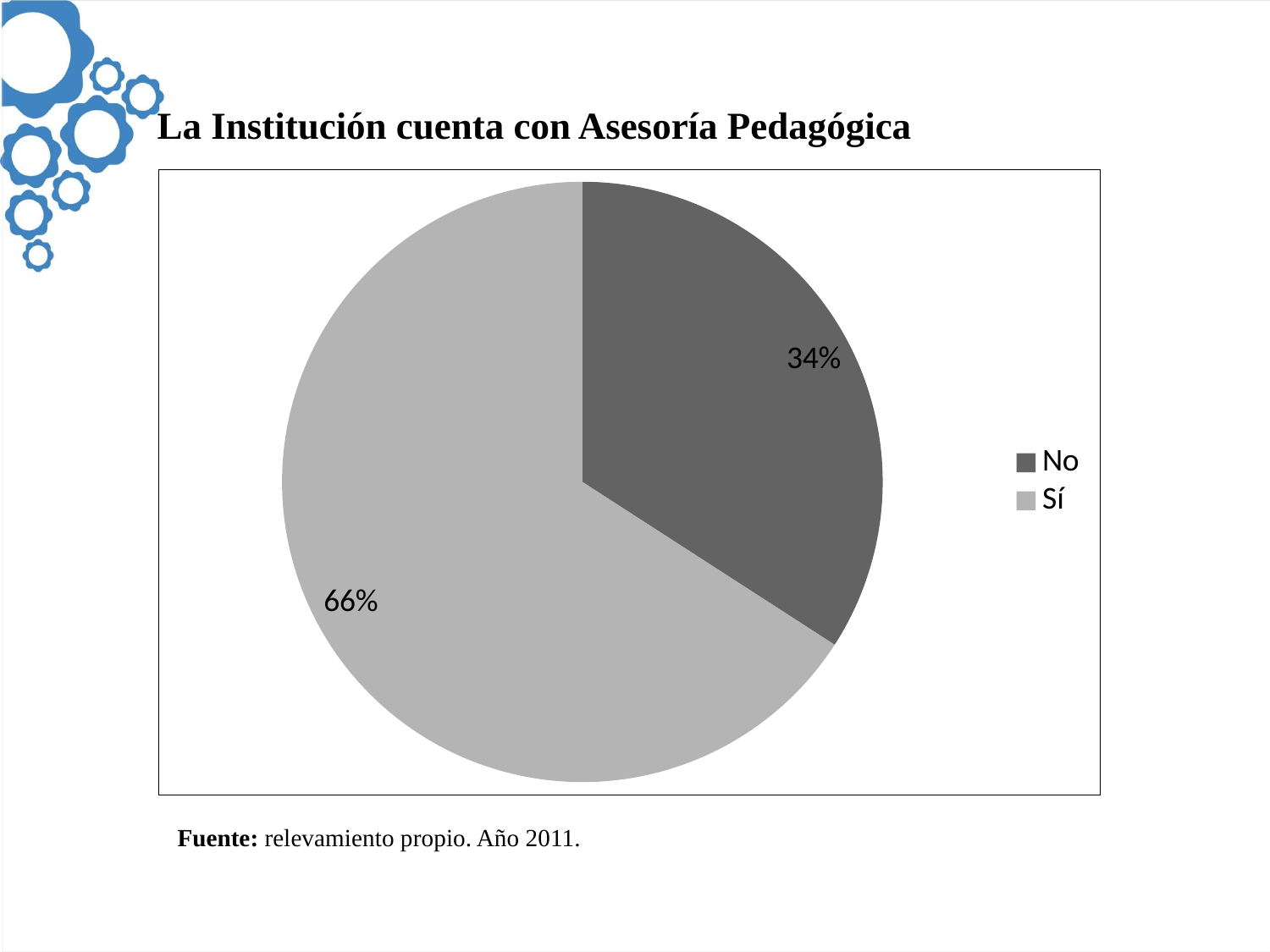
How many slices does the pie chart have? 2 What share of the pie does the "Sí" slice represent? 66% What percentage of the pie corresponds to "No"? 34% Which slice is larger, "Sí" or "No"? Sí Which legend entry is shown in the darker grey colour? No Which category has the smallest share of the pie? No What type of chart is shown on the slide? pie chart What percentage of the pie corresponds to "Sí"? 66% What is the title of the chart? La Institución cuenta con Asesoría Pedagógica How many entries does the legend list? 2 Which category has the largest share of the pie? Sí What is the difference in percentage points between the "Sí" and "No" slices? 32